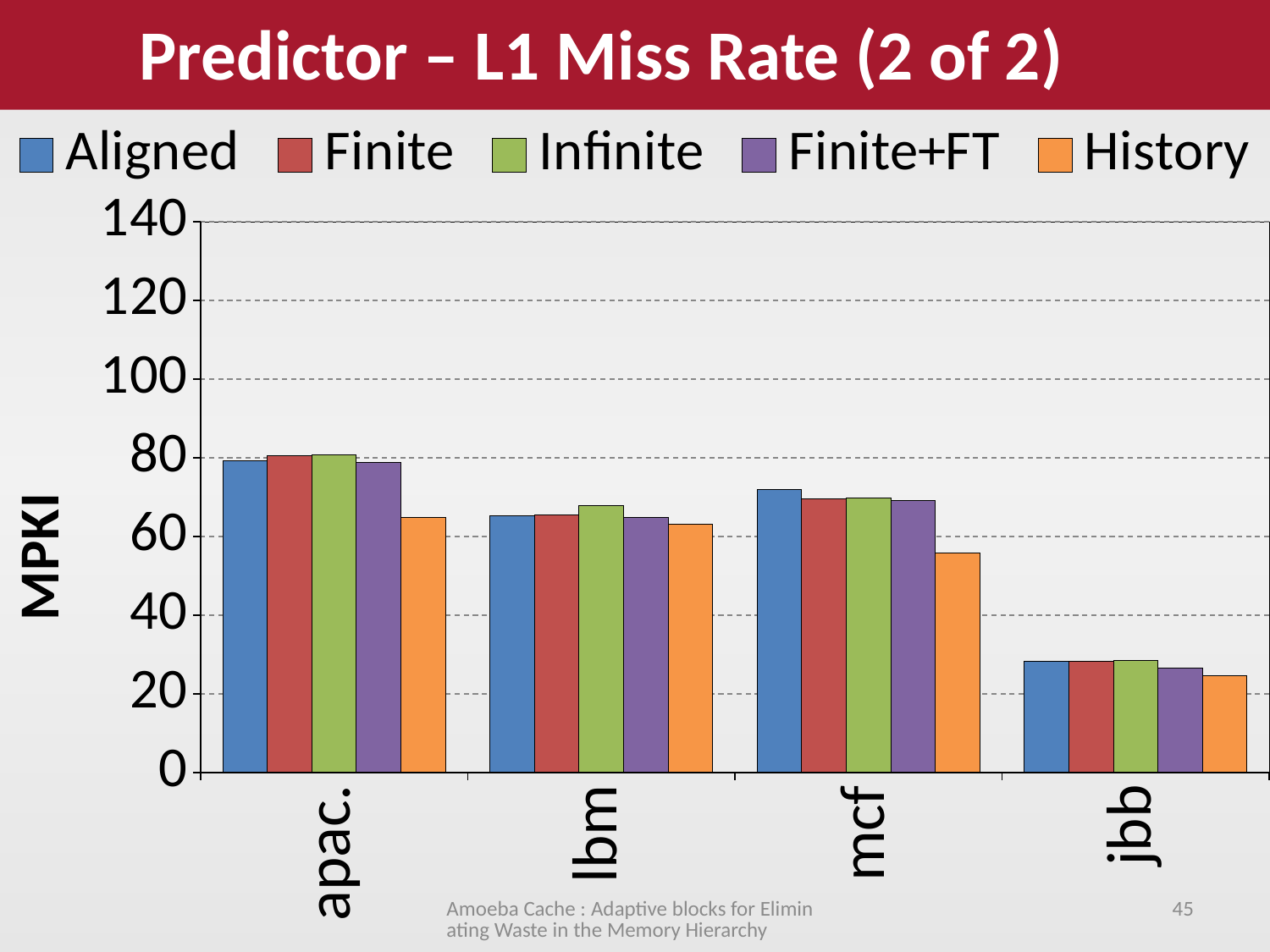
Is the Aligned value for mcf greater or less than 60? greater What kind of chart is shown on the slide? bar chart Is the Aligned value for jbb greater or less than 20? greater Is the Infinite value for apac. greater or less than 100? less How many categories are shown along the x axis? 4 For apac., which is larger: the Finite value or the History value? Finite How many series does the legend list? 5 What is the label of the y axis? MPKI Which category has the lowest values across all series? jbb For mcf, which is larger: the Aligned value or the History value? Aligned Which series is shown in orange in the legend? History